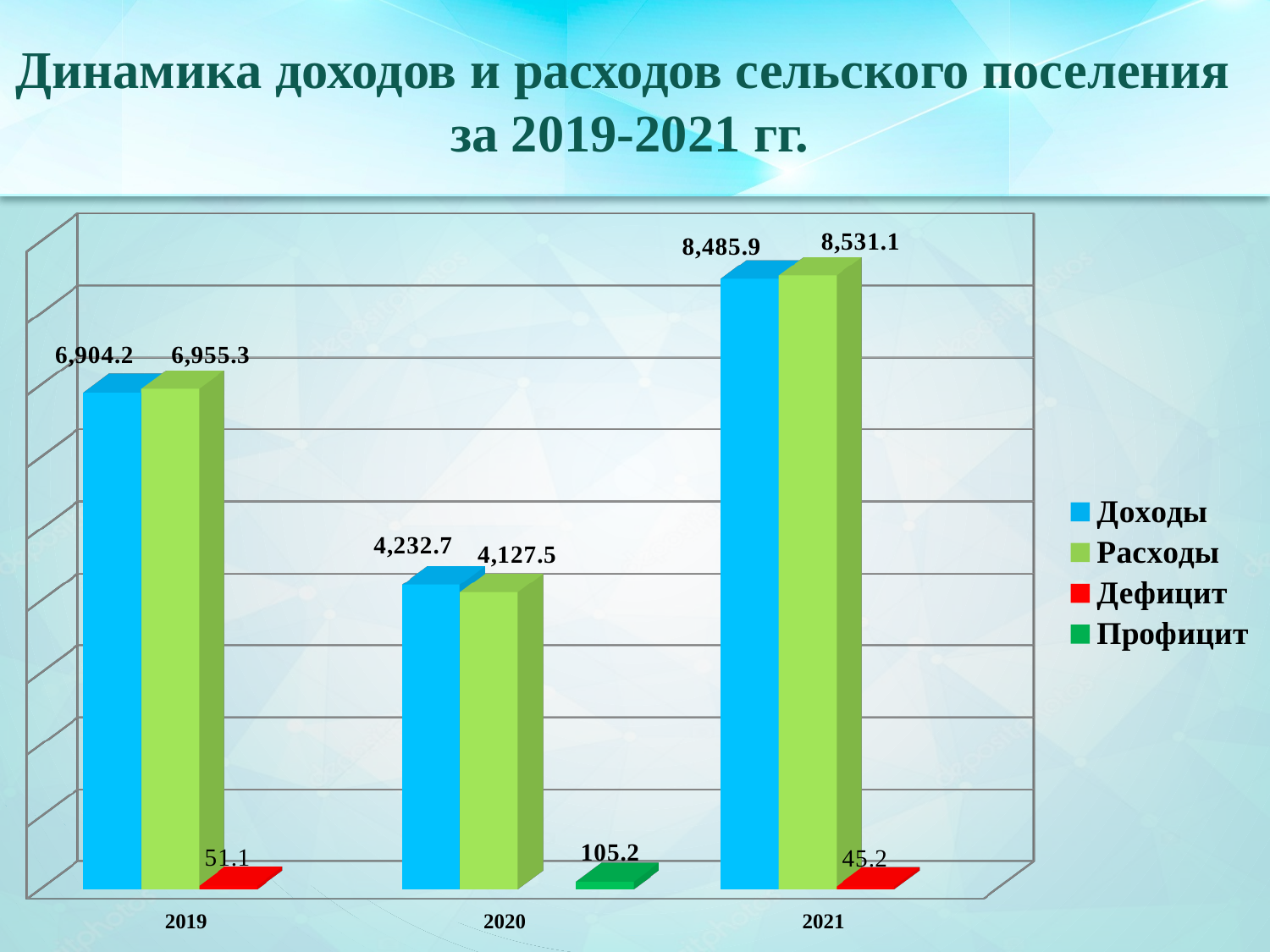
How many years are shown on the x axis? 3 What is the value of Расходы for 2021? 8,531.1 What is the value of Профицит for 2020? 105.2 What is the difference between Расходы and Доходы in 2019? 51.1 Which is larger in 2020, Доходы or Расходы? Доходы In which year is Расходы the lowest? 2020 What kind of chart is shown on the slide? Bar chart In which year is Доходы the highest? 2021 What is the value of Дефицит for 2021? 45.2 How many series does the legend list? 4 What is the difference between Доходы and Расходы in 2020? 105.2 What is the value of Доходы for 2019? 6,904.2